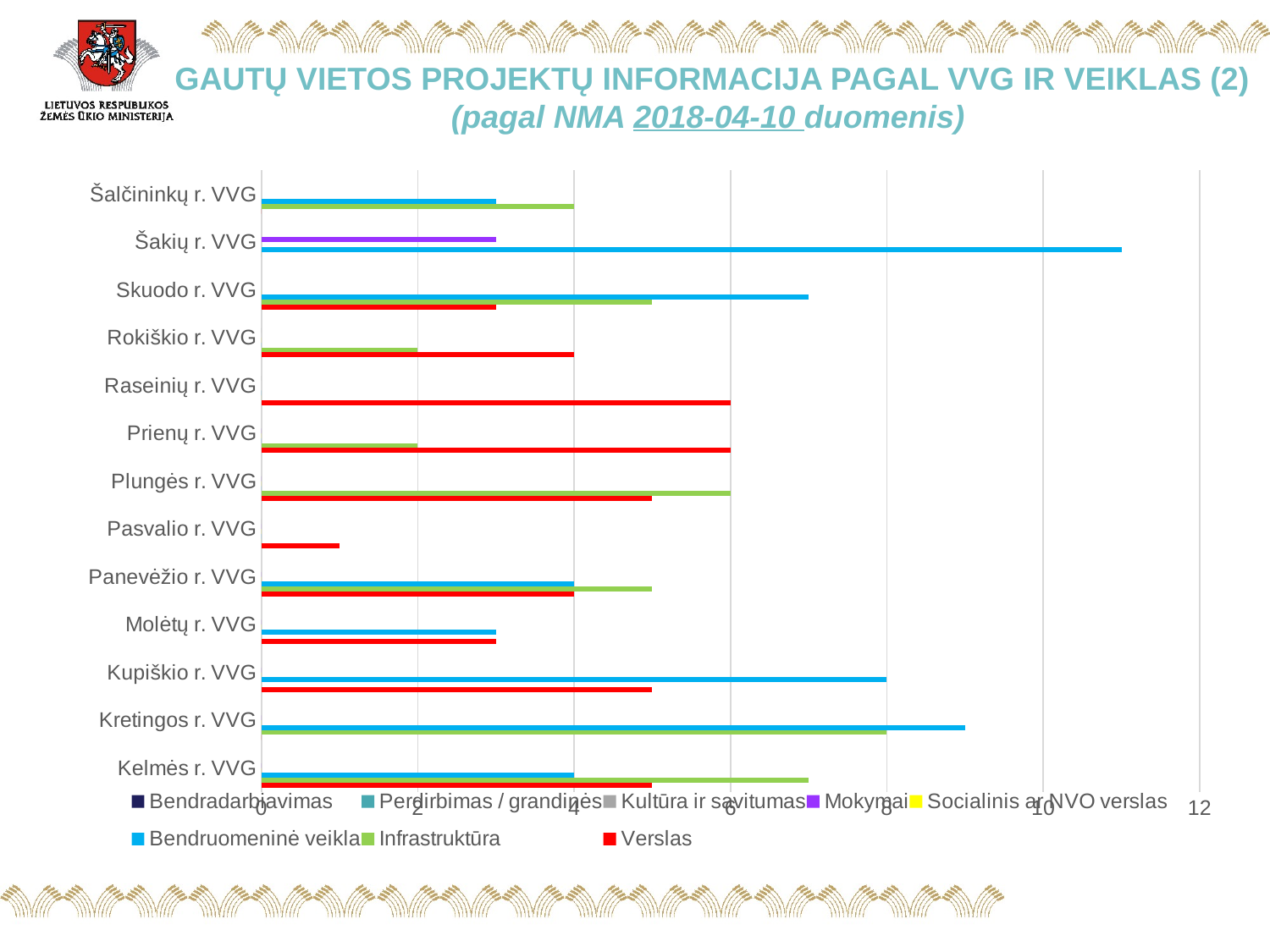
Is the Bendruomeninė veikla value for Šakių r. VVG greater or less than 10? greater What is the Verslas value for Raseinių r. VVG? 6 How many series does the chart legend list? 8 Which is larger for Skuodo r. VVG: the Bendruomeninė veikla value or the Verslas value? Bendruomeninė veikla What is the Bendruomeninė veikla value for Kupiškio r. VVG? 8 How many VVG categories are listed on the vertical axis of the chart? 13 Which is larger for Plungės r. VVG: the Infrastruktūra value or the Verslas value? Infrastruktūra Which VVG has the longest bar in the chart? Šakių r. VVG Which series in the legend is shown in red? Verslas Is the Bendruomeninė veikla value for Kretingos r. VVG greater or less than 8? greater Is the Verslas value for Pasvalio r. VVG greater or less than 2? less What type of chart is shown on the slide? bar chart